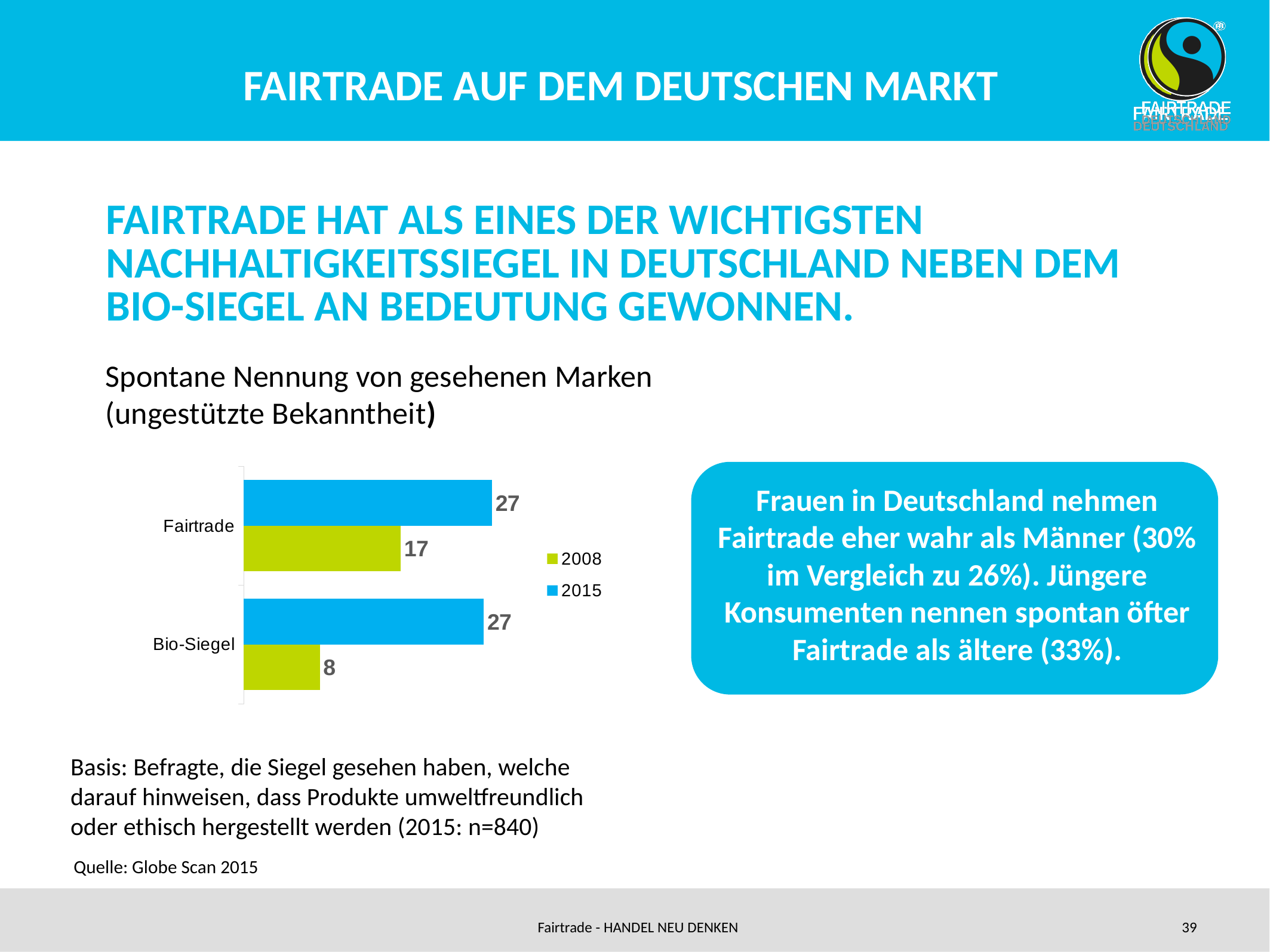
What kind of chart is shown on the slide? Bar chart What is the difference between the 2015 and 2008 values for Fairtrade? 10 How many categories are shown in the chart? 2 Which is larger: the 2008 value for Fairtrade or the 2008 value for Bio-Siegel? Fairtrade Which category has the lowest value in 2008? Bio-Siegel How many series does the legend list? 2 What is the value for Bio-Siegel in 2015? 27 Which category has the highest value in 2008? Fairtrade What is the value for Fairtrade in 2015? 27 What is the difference between the 2015 and 2008 values for Bio-Siegel? 19 What is the value for Fairtrade in 2008? 17 What is the value for Bio-Siegel in 2008? 8